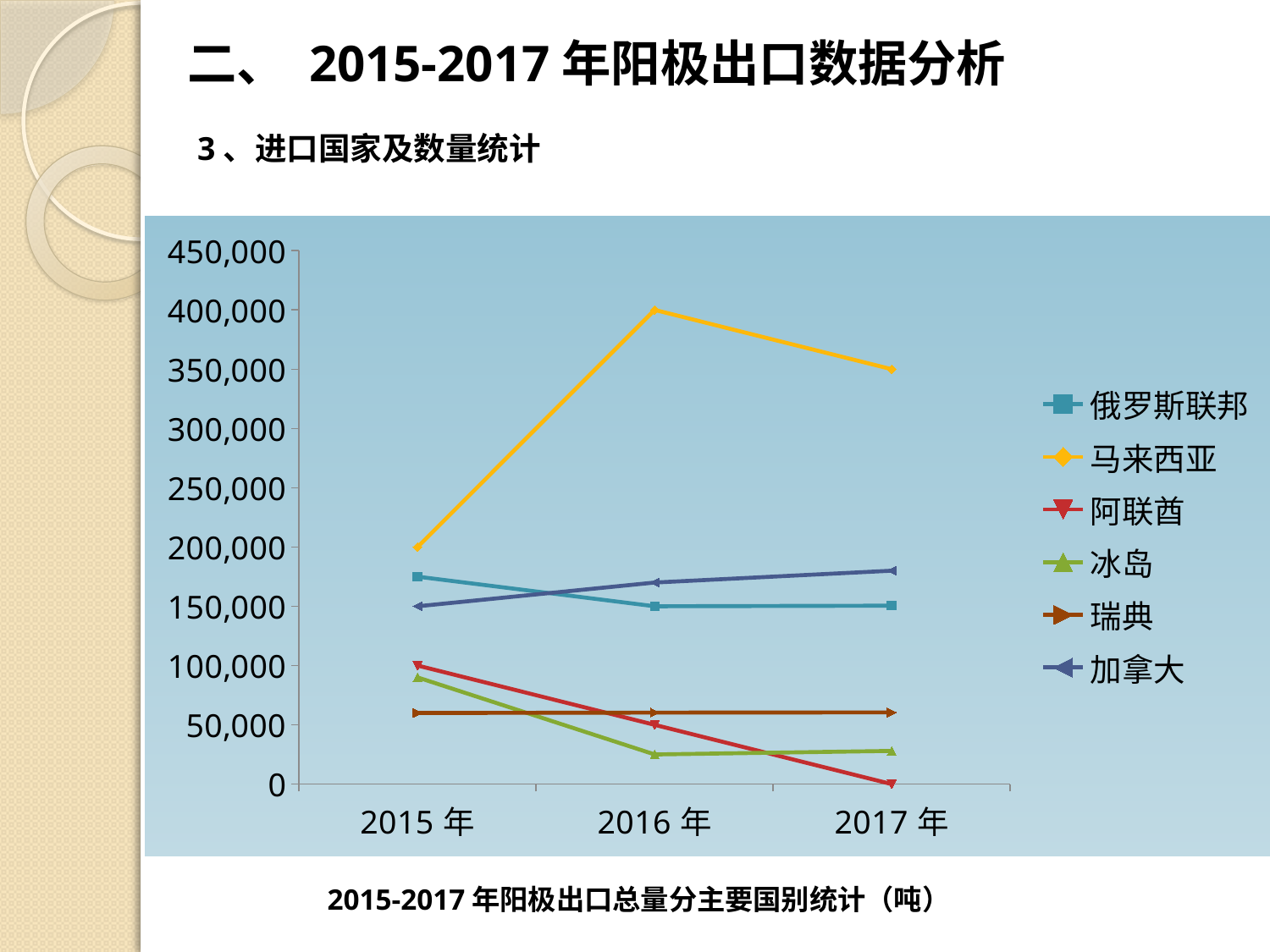
How many series does the legend list? 6 What kind of chart is shown on the slide? line chart What is the value for 俄罗斯联邦 in 2016年? 150,000 How many years are shown on the x axis? 3 What is the value for 马来西亚 in 2016年? 400,000 Which series has the lowest value in 2017年? 阿联酋 Which series has the highest value in 2016年? 马来西亚 What is the difference between the 马来西亚 values in 2016年 and 2017年? 50,000 What is the value for 阿联酋 in 2017年? 0 What is the value for 马来西亚 in 2015年? 200,000 Do the values for 阿联酋 rise or fall from 2015年 to 2017年? fall Is the value for 瑞典 in 2015年 greater or less than 50,000? greater